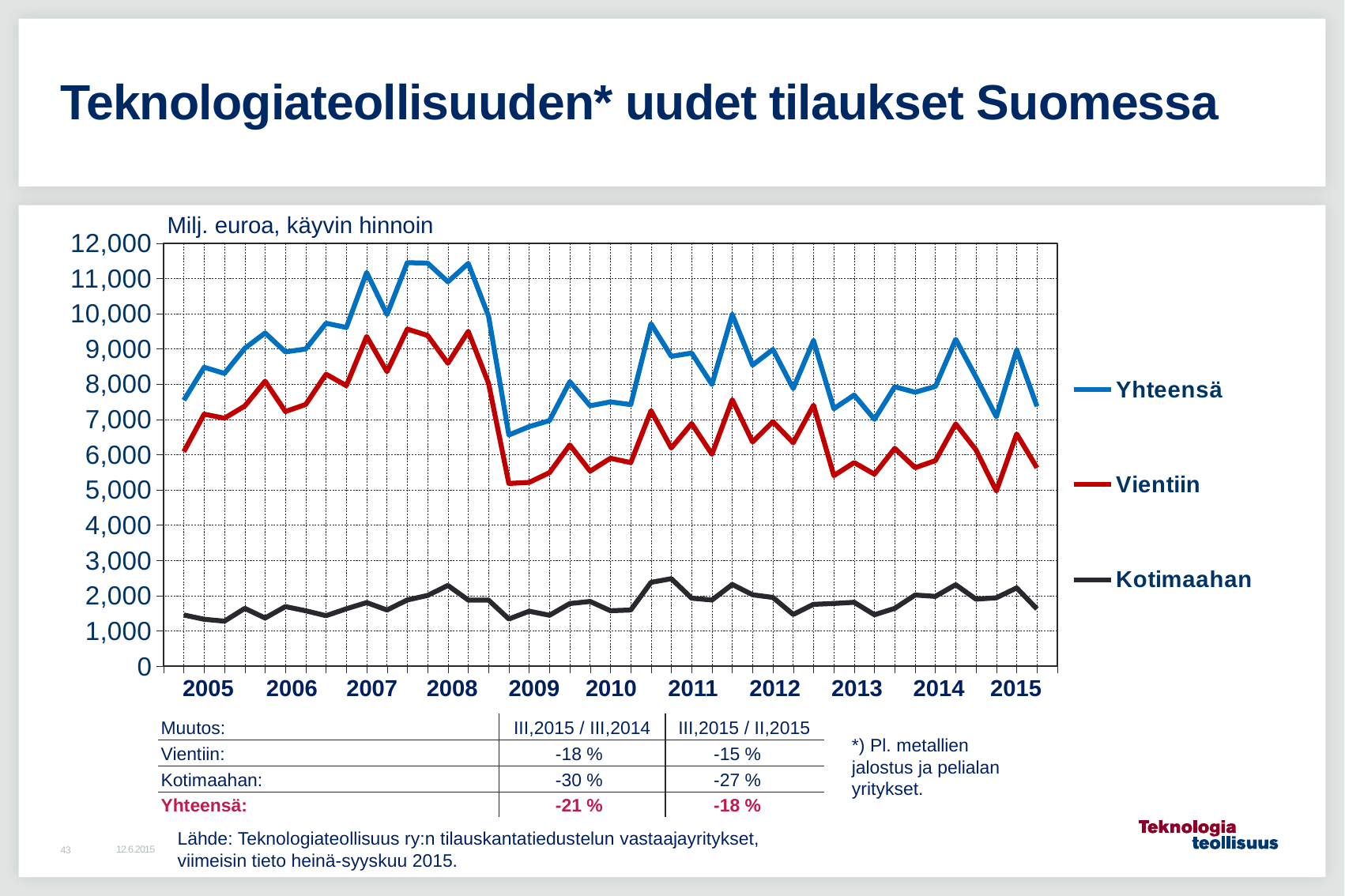
Which is larger in 2011: the Vientiin series or the Kotimaahan series? Vientiin Does the Yhteensä series rise or fall from 2005 to the start of 2008? rise What colour is the Vientiin line in the chart? red What kind of chart is shown on the slide? line chart How many series does the legend list? 3 Which series is plotted with the lowest values throughout the chart? Kotimaahan Is the Kotimaahan series ever greater or less than 3,000 over the whole period? less Is the lowest value of the Vientiin series in 2009 greater or less than 6,000? less Which series is plotted with the highest values throughout the chart? Yhteensä What unit is stated above the chart's y axis? Milj. euroa, käyvin hinnoin Is the lowest value of the Yhteensä series in 2009 greater or less than 7,000? less